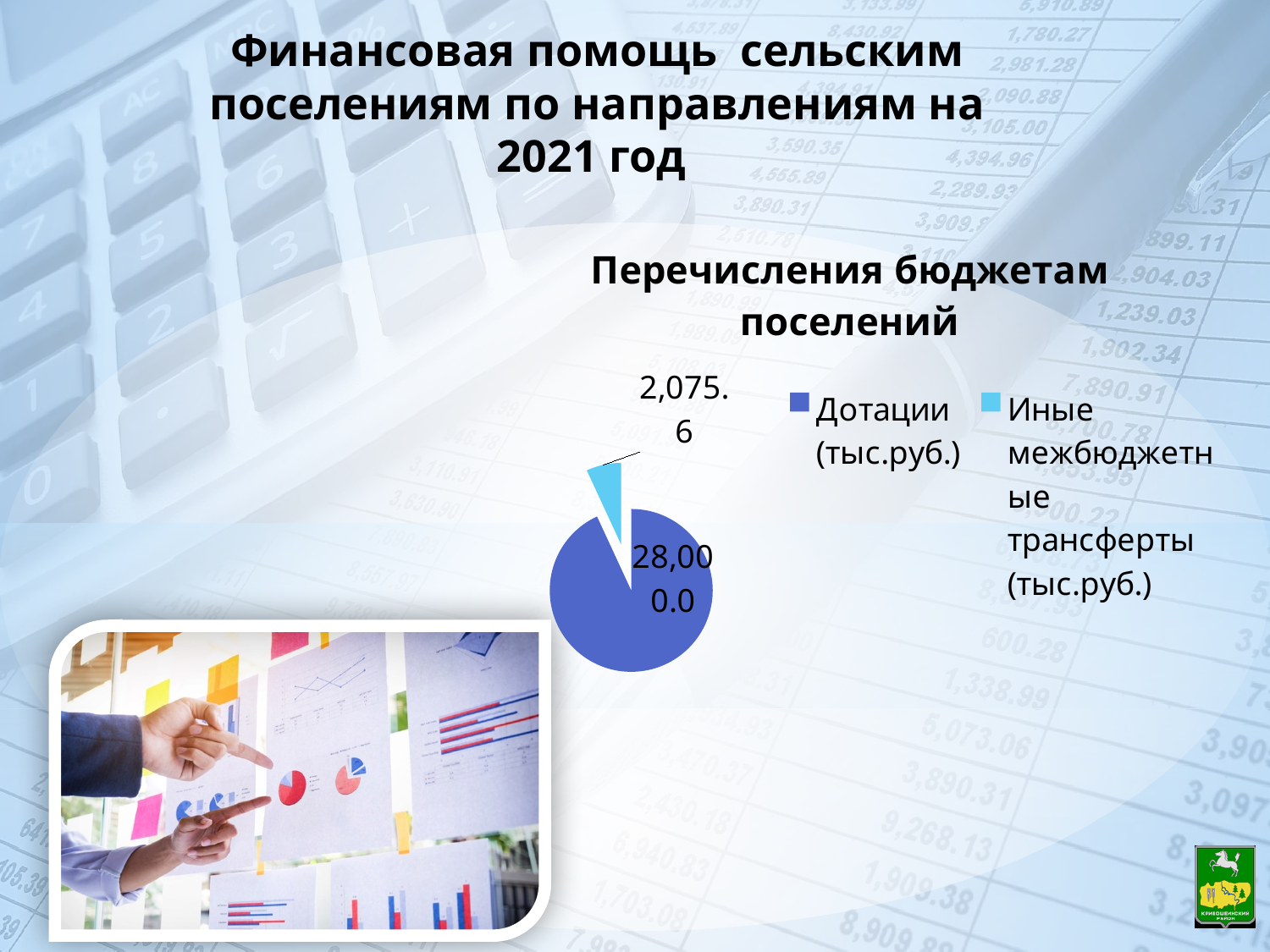
What type of chart is shown on the slide? pie chart Which is larger in the pie chart: Дотации or Иные межбюджетные трансферты? Дотации What is the value for Иные межбюджетные трансферты (тыс.руб.) in the pie chart? 2,075.6 What is the value for Дотации (тыс.руб.) in the pie chart? 28,000.0 Which category has the largest slice in the pie chart? Дотации (тыс.руб.) How many entries does the legend of the pie chart list? 2 Which category has the smallest slice in the pie chart? Иные межбюджетные трансферты (тыс.руб.) What colour is the Дотации slice in the pie chart? dark blue What is the difference between the values for Дотации and Иные межбюджетные трансферты in the pie chart? 25,924.4 What is the total of the two values shown in the pie chart? 30,075.6 How many slices does the pie chart have? 2 What is the title of the chart on the slide? Перечисления бюджетам поселений